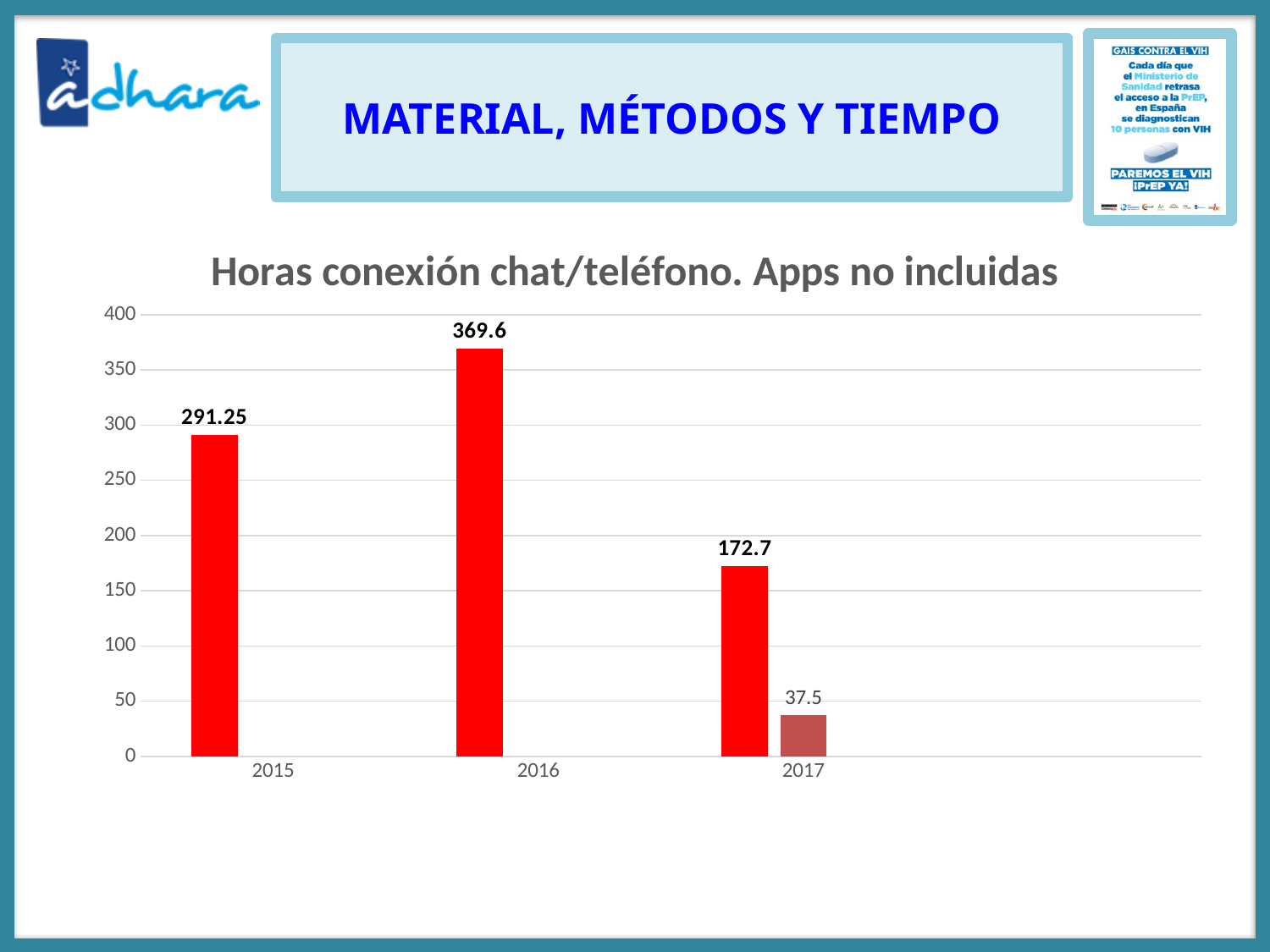
What is the title of the chart? Horas conexión chat/teléfono. Apps no incluidas What is the difference between the red bar values for 2016 and 2015? 78.35 What is the value of the smaller brown bar shown for 2017? 37.5 What is the value of the red bar for 2017? 172.7 How many years are shown on the x axis? 3 Which is larger, the red bar for 2015 or the red bar for 2017? 2015 Which year has the highest red bar? 2016 What is the value of the red bar for 2015? 291.25 Which year has the lowest red bar? 2017 What is the value of the red bar for 2016? 369.6 What is the difference between the red bar values for 2016 and 2017? 196.9 What kind of chart is shown on the slide? Bar chart